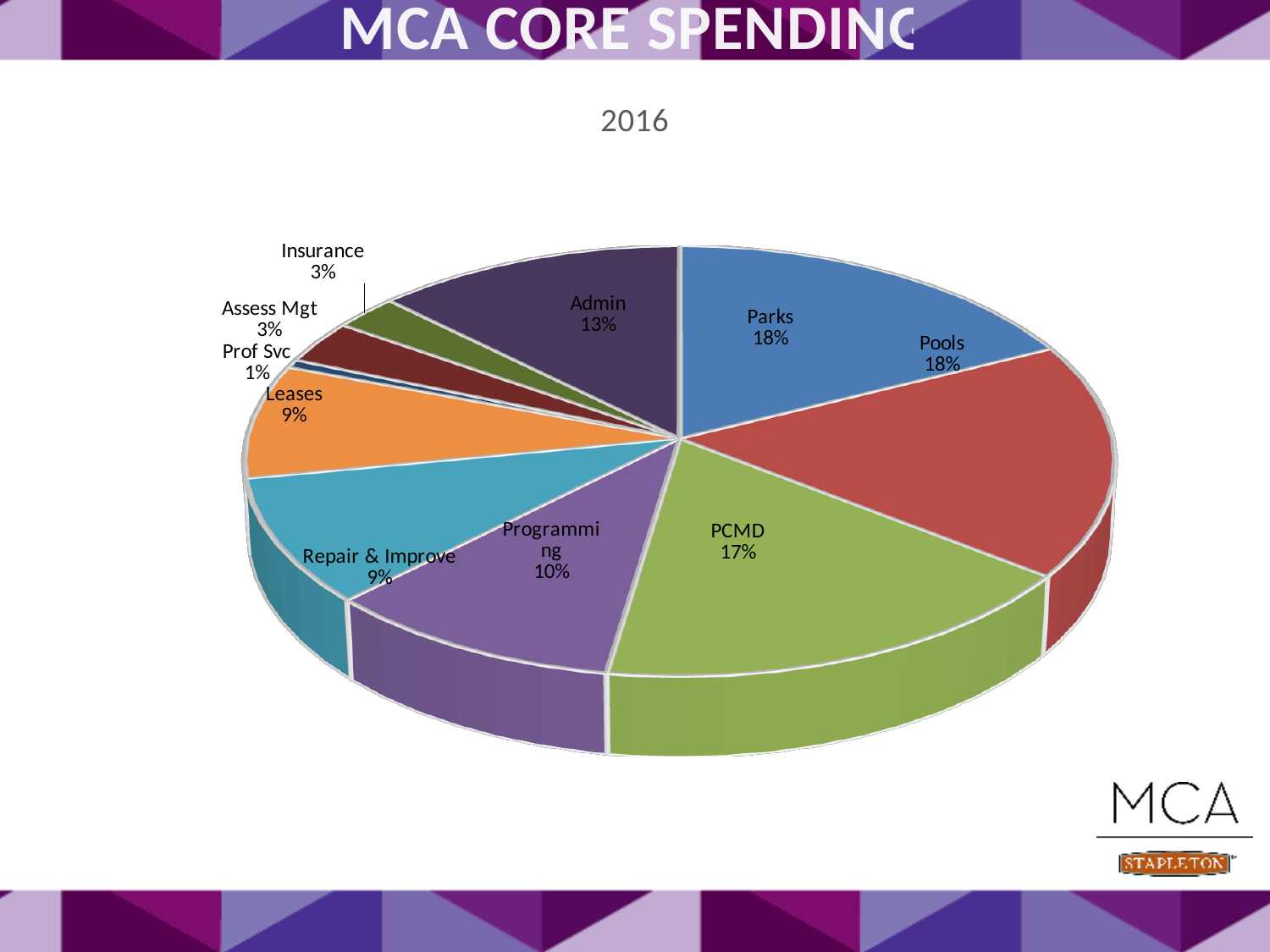
What is the difference in percentage points between PCMD and Repair & Improve? 8 What percentage is shown for PCMD? 17% What share of the pie does Parks represent? 18% How many slices does the pie chart have? 10 What year is shown as the chart title? 2016 Which is larger, the slice for Programming or the slice for Insurance? Programming What percentage is shown for Programming? 10% What type of chart is shown on the slide? Pie chart What share does Leases account for? 9% Which category has the smallest slice of the pie? Prof Svc What is the value for Admin? 13% What is the difference in percentage points between Parks and Admin? 5